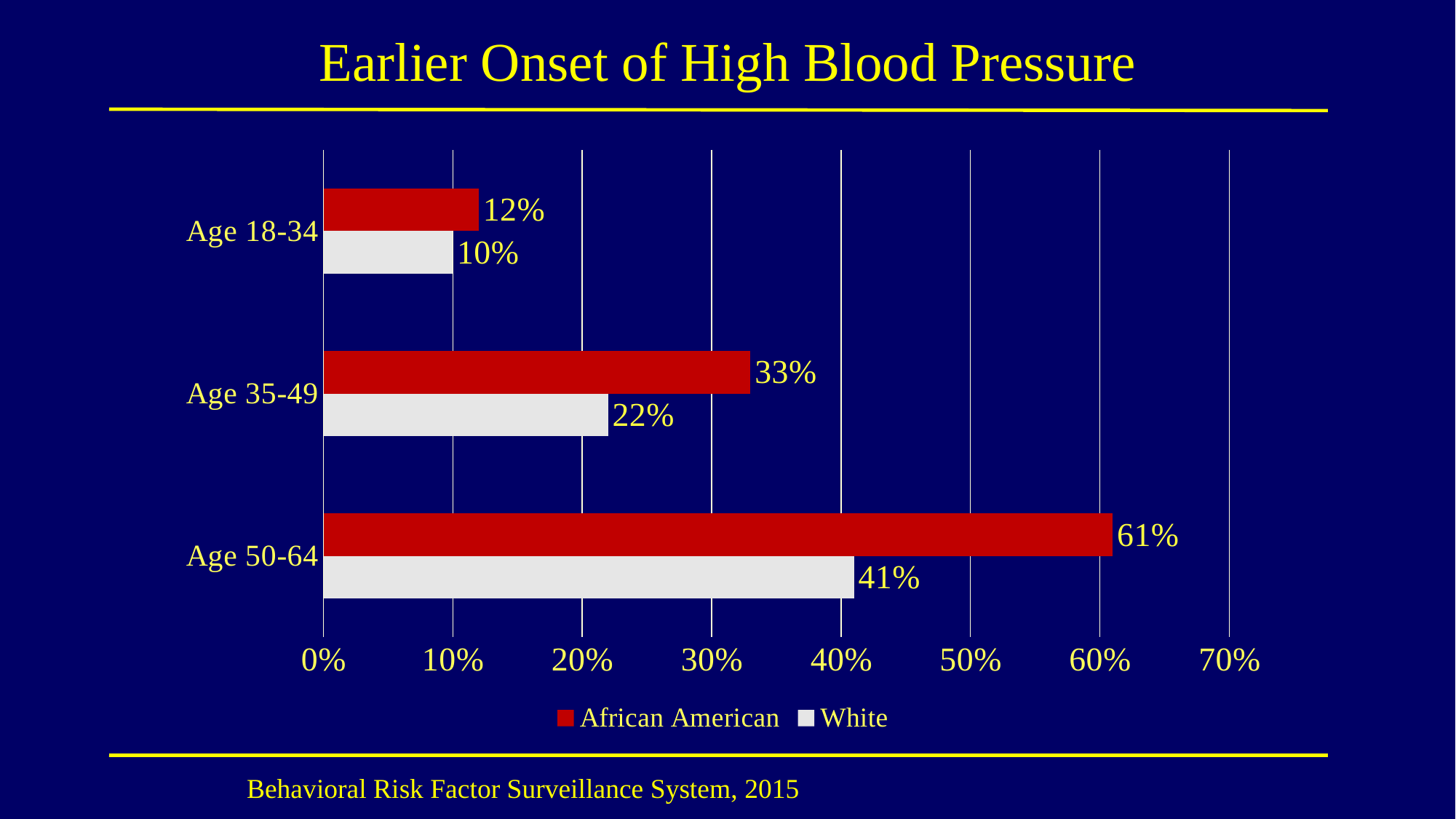
What is the value for White in the Age 35-49 group? 22% What is the difference between the African American and White values in the Age 35-49 group? 11% Which age group has the lowest value for African American? Age 18-34 What is the value for African American in the Age 18-34 group? 12% What is the value for African American in the Age 50-64 group? 61% How many series does the legend list? 2 In the Age 18-34 group, which is larger: the African American value or the White value? African American What kind of chart is shown on the slide? Bar chart Which age group has the highest value for White? Age 50-64 How many age groups are shown on the chart? 3 What is the difference between the African American and White values in the Age 50-64 group? 20% Is the value for White in the Age 50-64 group greater or less than 50%? less